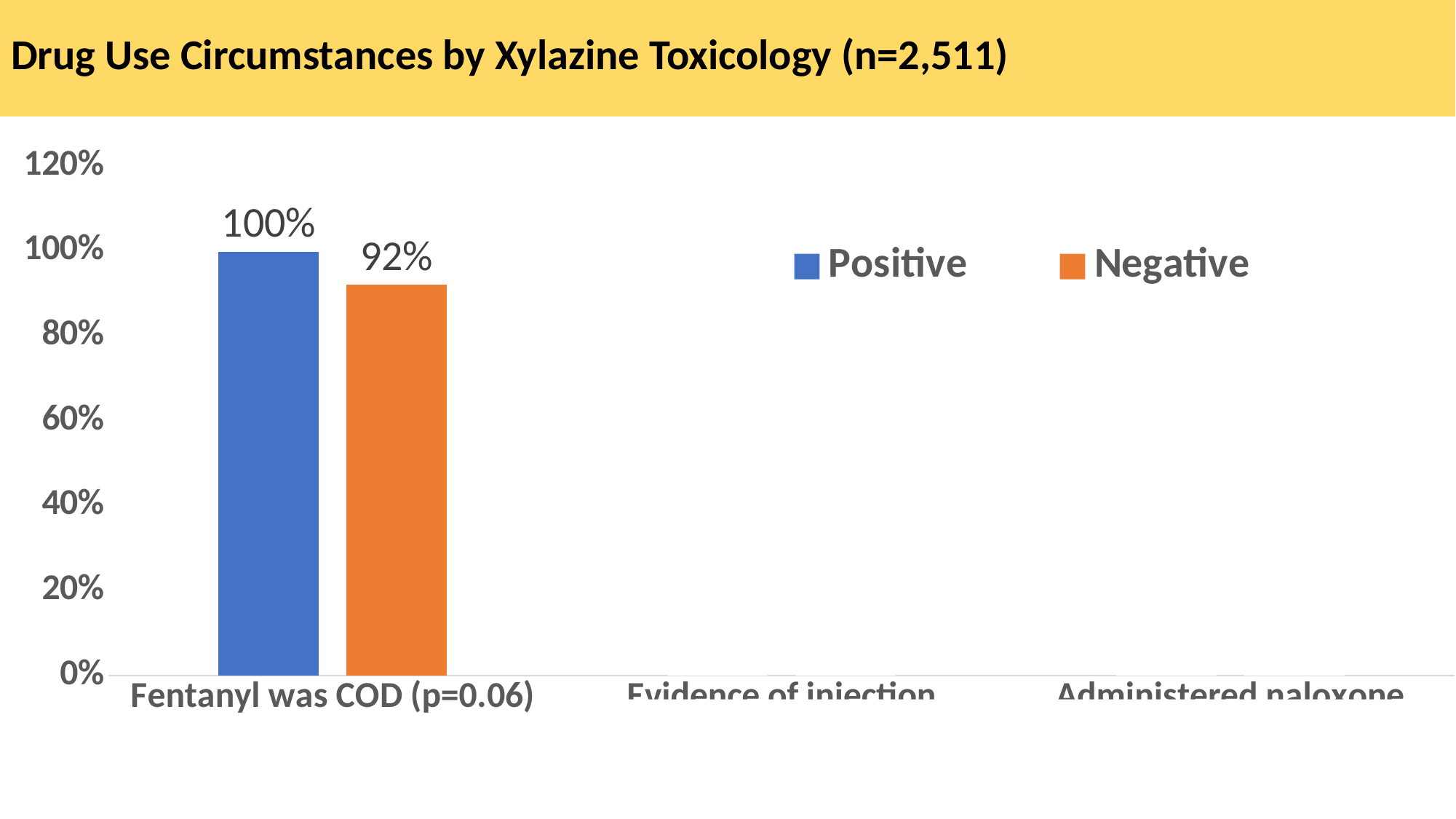
What is the value for Positive in the Fentanyl was COD (p=0.06) category? 100% What is the difference between the Positive and Negative values for Fentanyl was COD (p=0.06)? 8% What is the title of the chart? Drug Use Circumstances by Xylazine Toxicology (n=2,511) Which series has the larger value for Fentanyl was COD (p=0.06), Positive or Negative? Positive What colour are the bars for the Negative series? orange How many series does the legend list? 2 Is the Negative value for Fentanyl was COD (p=0.06) greater or less than 80%? greater What kind of chart is shown on the slide? bar chart What is the highest value shown on the y axis? 120% What is the value for Negative in the Fentanyl was COD (p=0.06) category? 92%